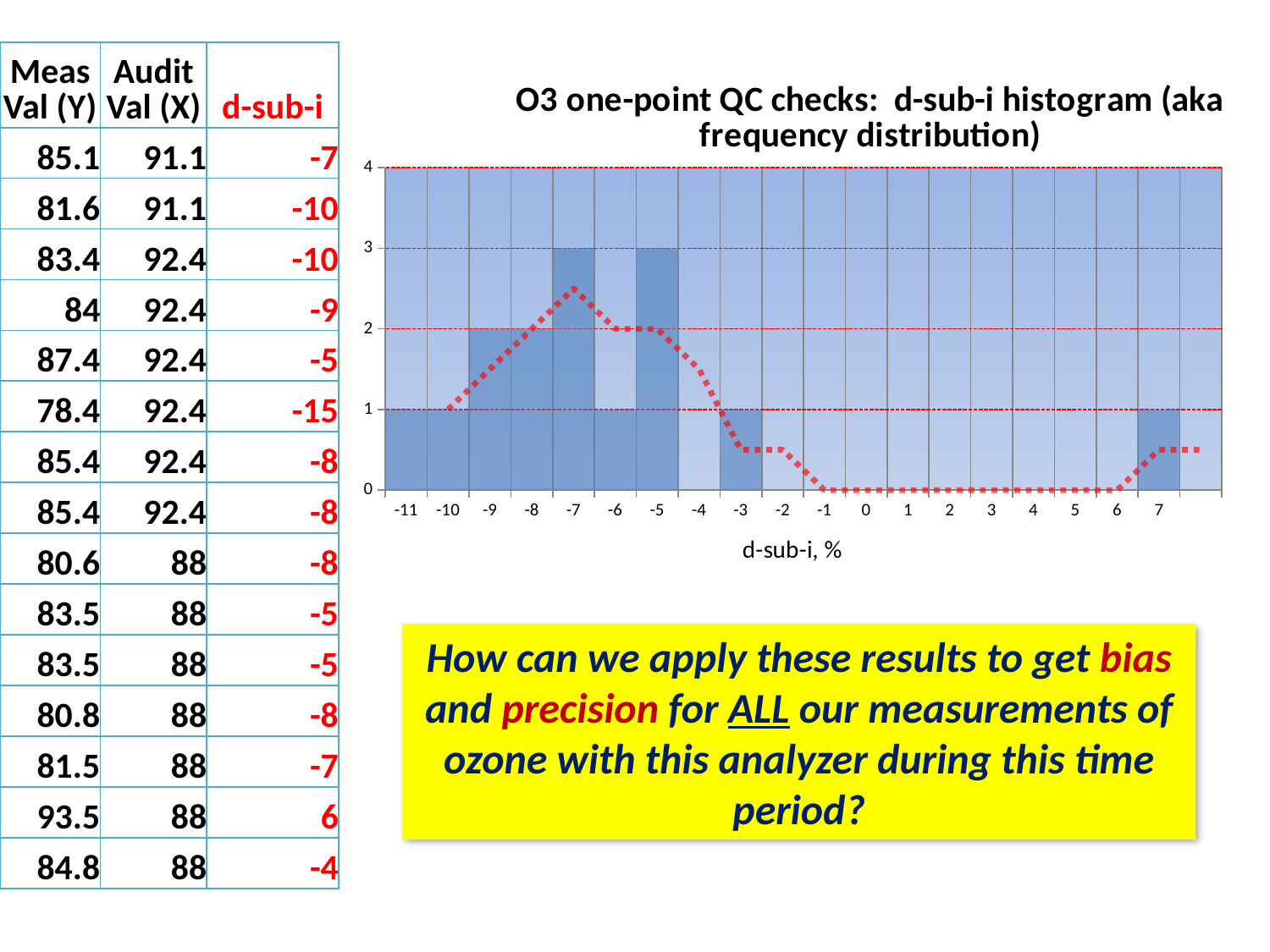
What is the frequency for d-sub-i = -7? 3 Which has a higher frequency, d-sub-i = -7 or d-sub-i = -9? -7 What kind of chart is shown on the slide? bar chart (histogram) What is the frequency for d-sub-i = -11? 1 How many d-sub-i categories are labeled on the x axis? 19 What is the title of the chart? O3 one-point QC checks: d-sub-i histogram (aka frequency distribution) What is the frequency for d-sub-i = 0? 0 What is the x-axis label of the chart? d-sub-i, % Do the bar heights rise or fall from d-sub-i = -11 to d-sub-i = -7? rise What is the frequency for d-sub-i = -5? 3 What is the frequency for d-sub-i = 7? 1 What is the difference in frequency between d-sub-i = -7 and d-sub-i = -9? 1